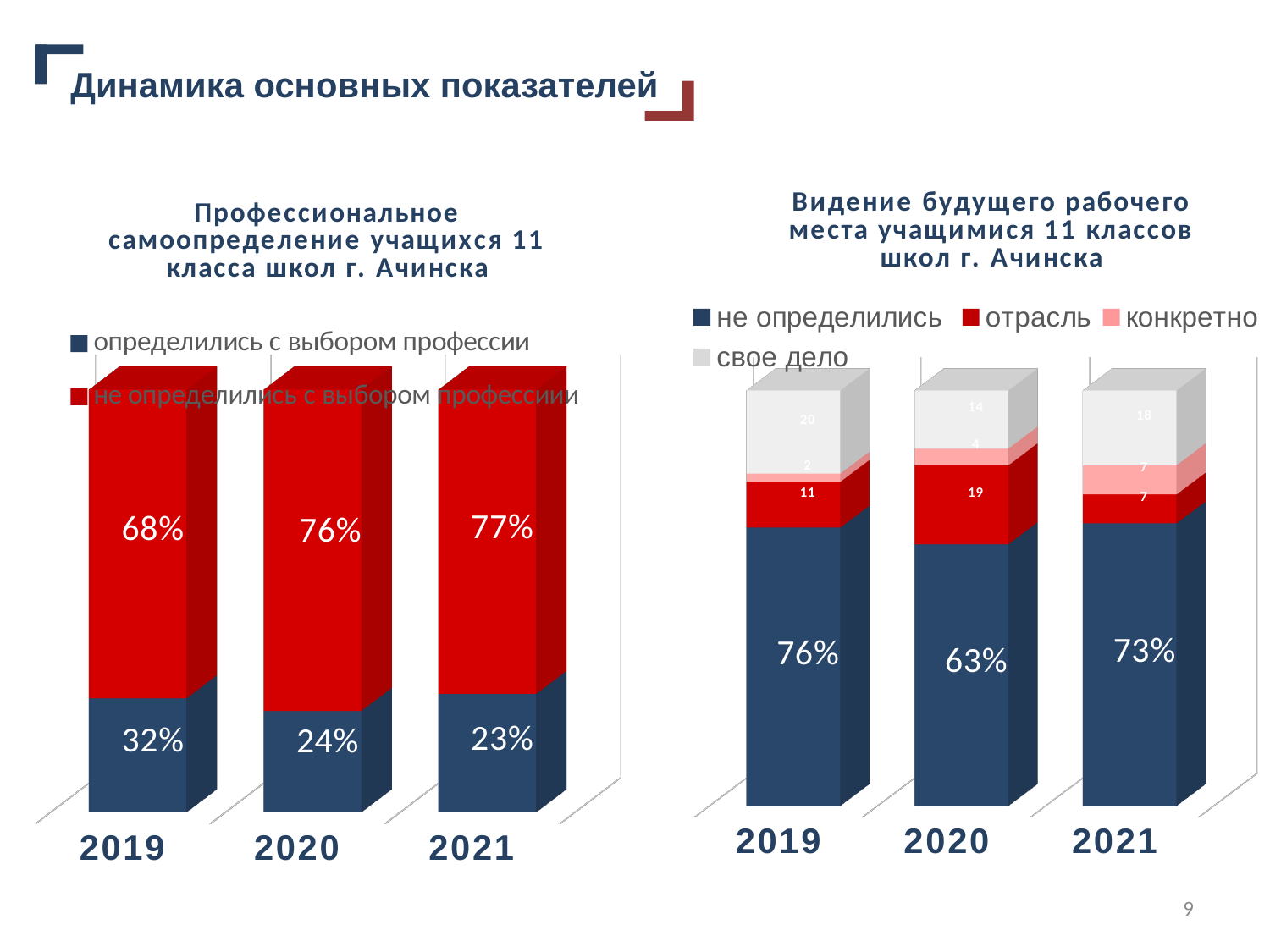
On the right chart (Видение будущего рабочего места), what is the value for 'отрасль' in 2020? 19 On the right chart (Видение будущего рабочего места), what is the value for 'свое дело' in 2019? 20 On the right chart (Видение будущего рабочего места), which is larger: the 'конкретно' value in 2021 or in 2019? 2021 On the right chart (Видение будущего рабочего места), how many series does the legend list? 4 On the left chart (Профессиональное самоопределение), does the share of 'определились с выбором профессии' rise or fall from 2019 to 2021? fall On the right chart (Видение будущего рабочего места), what is the value for 'не определились' in 2020? 63% What type of chart is the right chart (Видение будущего рабочего места)? stacked bar chart On the left chart (Профессиональное самоопределение), what is the value for 'определились с выбором профессии' in 2019? 32% On the left chart (Профессиональное самоопределение), what is the difference between the 'не определились' values for 2020 and 2019? 8% On the left chart (Профессиональное самоопределение), in which year is the share of 'определились с выбором профессии' the highest? 2019 On the left chart (Профессиональное самоопределение), what is the value for 'не определились с выбором профессии' in 2021? 77% On the left chart (Профессиональное самоопределение), how many series does the legend list? 2